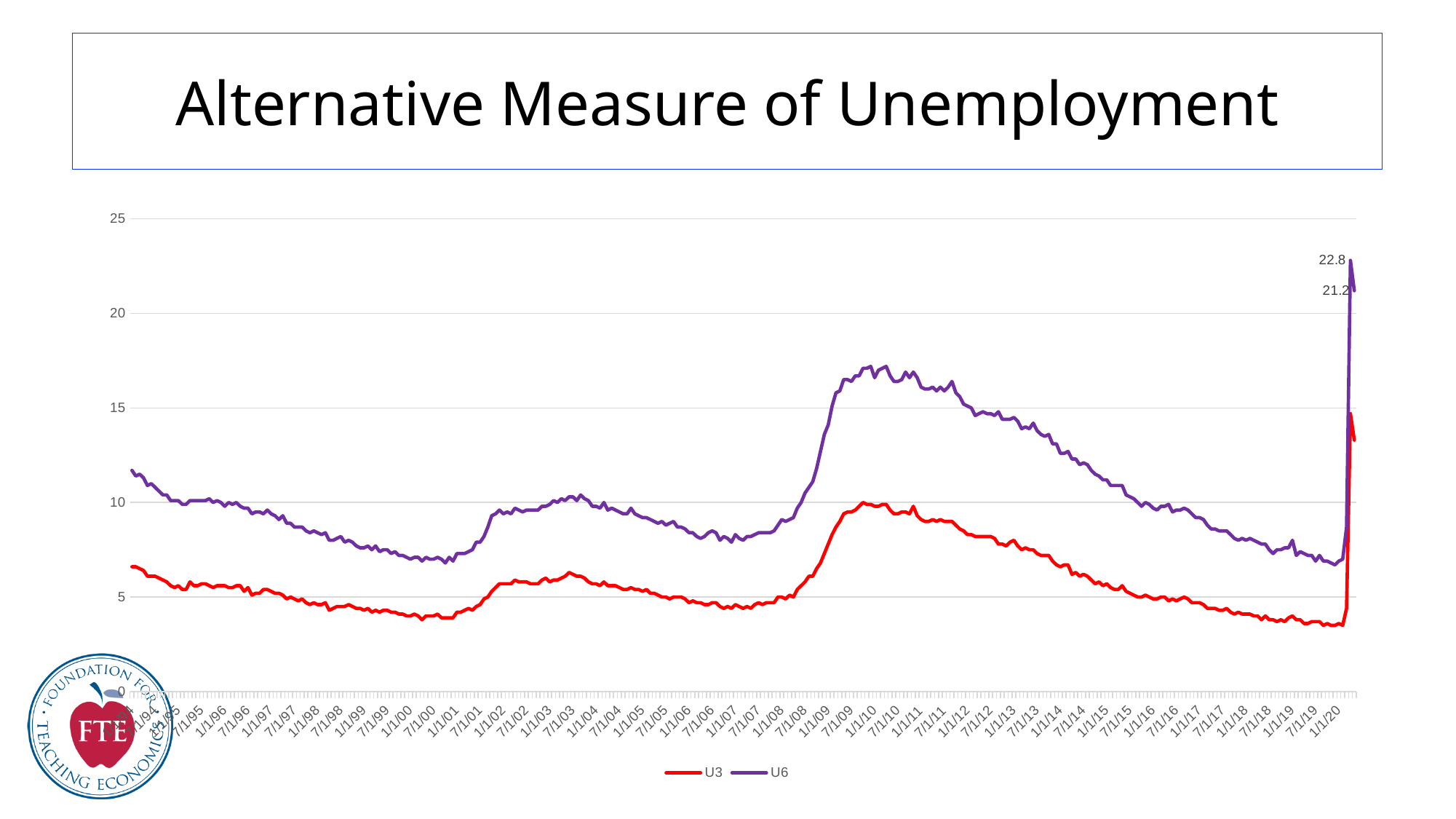
Is the value for U3 at 1/1/94 greater or less than 10? less How many series does the legend list? 2 What is the highest labelled value on the U6 line? 22.8 Between 1/1/10 and 1/1/19, does the U6 line generally rise or fall? fall Which series is higher at 1/1/10, U3 or U6? U6 Is the value for U3 at 1/1/00 greater or less than 5? less Is the value for U6 at 1/1/10 greater or less than 15? greater What is the second data label shown near the end of the U6 line? 21.2 What kind of chart is shown on the slide? line chart What are the two series named in the legend? U3 and U6 Which series reaches the highest value on the chart? U6 What is the difference between the two labelled U6 values, 22.8 and 21.2? 1.6